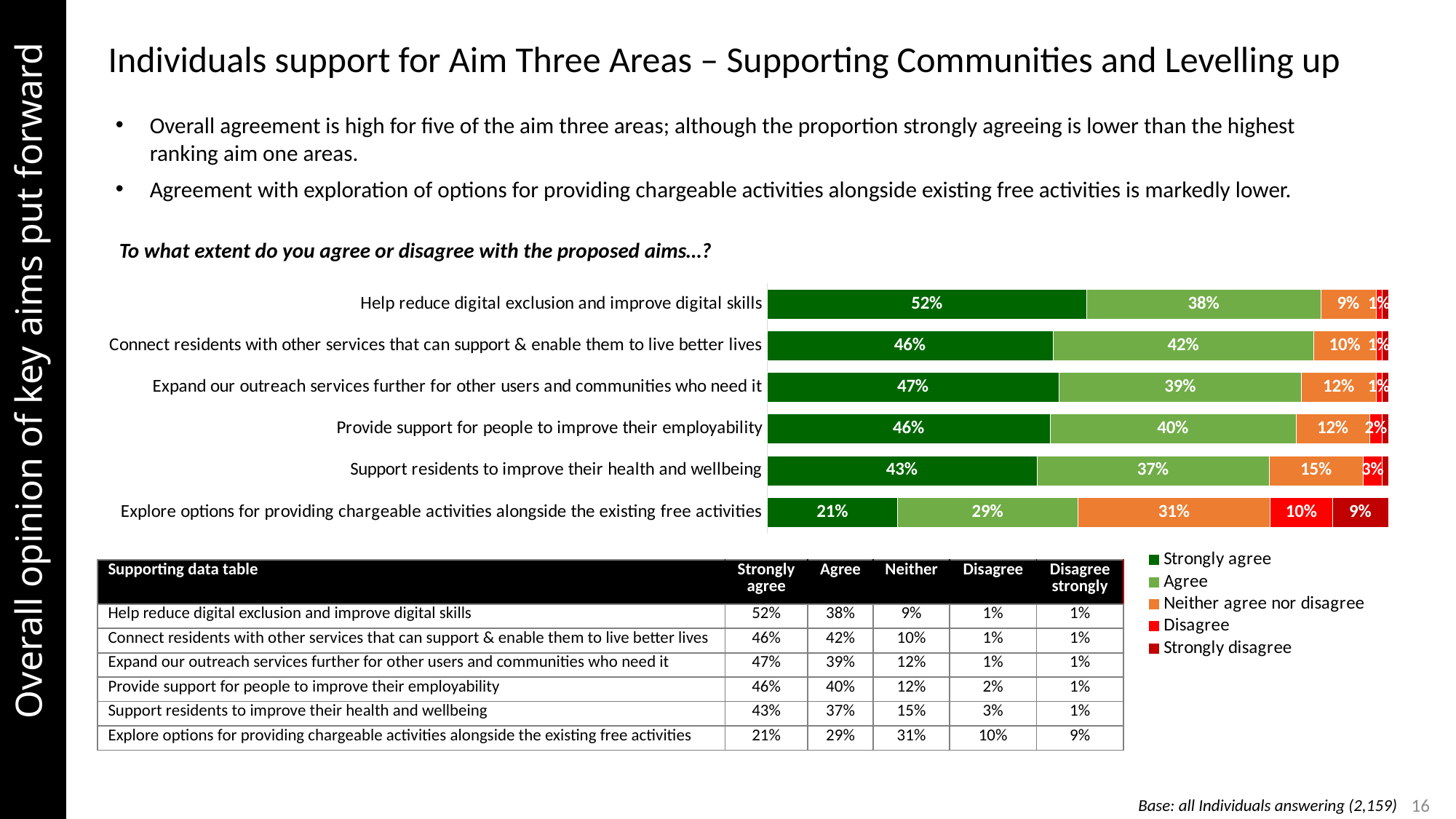
Which aim has the highest 'Strongly agree' percentage? Help reduce digital exclusion and improve digital skills What colour represents 'Strongly disagree' in the chart legend? Dark red What is the 'Neither agree nor disagree' value for 'Explore options for providing chargeable activities alongside the existing free activities'? 31% What is the 'Disagree' value for 'Explore options for providing chargeable activities alongside the existing free activities'? 10% Which aim has the lowest 'Strongly agree' percentage? Explore options for providing chargeable activities alongside the existing free activities What is the combined 'Strongly agree' and 'Agree' percentage for 'Support residents to improve their health and wellbeing'? 80% What percentage strongly agree with 'Help reduce digital exclusion and improve digital skills'? 52% Which has a higher 'Agree' percentage: 'Connect residents with other services that can support & enable them to live better lives' or 'Provide support for people to improve their employability'? Connect residents with other services that can support & enable them to live better lives How many series does the legend list? 5 What kind of chart is shown on the slide? Stacked bar chart What is the difference in 'Strongly agree' between 'Help reduce digital exclusion and improve digital skills' and 'Explore options for providing chargeable activities alongside the existing free activities'? 31 percentage points How many aims (categories) are shown in the chart? 6